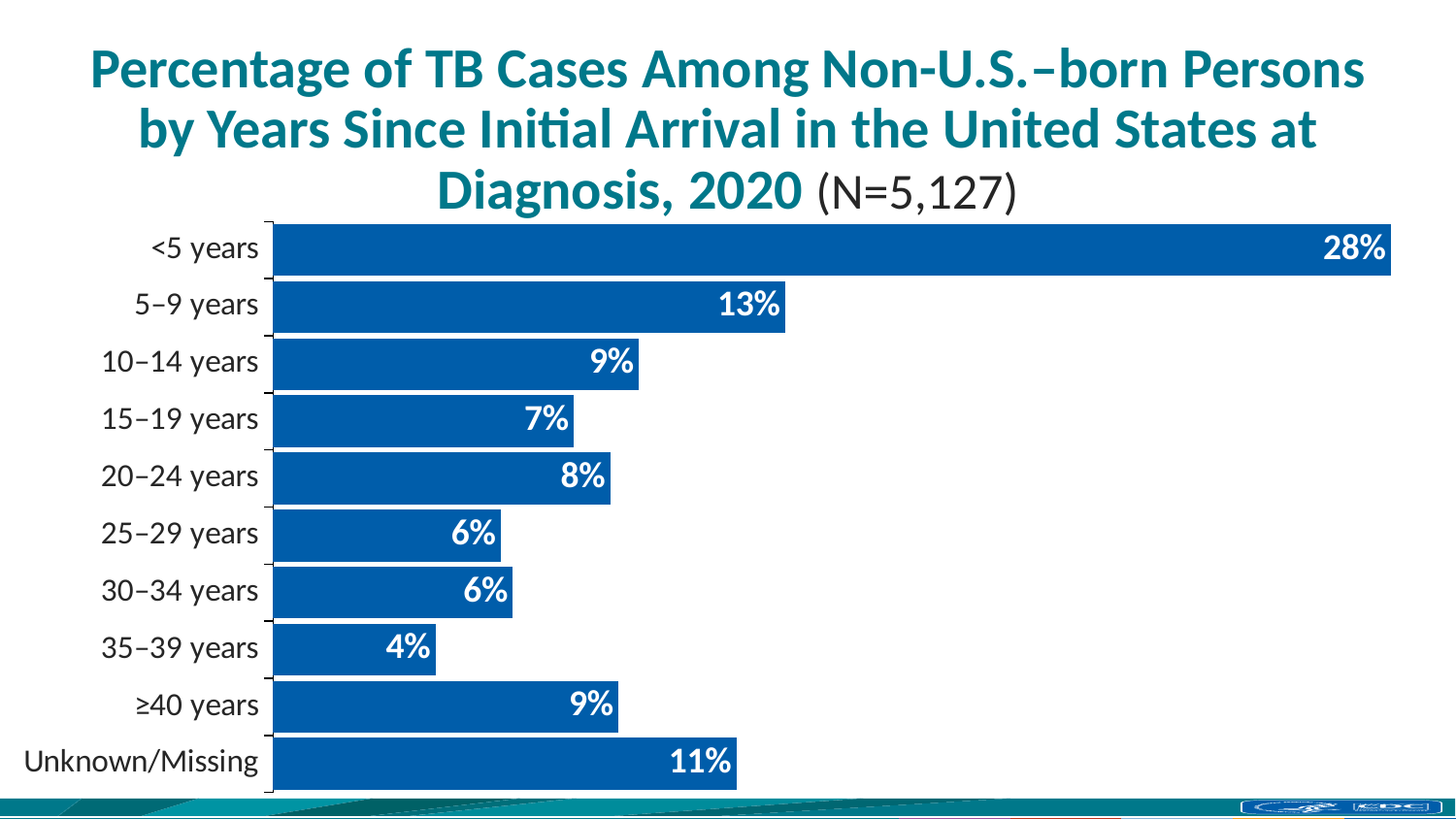
Which is larger, the value for 10–14 years or the value for 35–39 years? 10–14 years Which category has the highest percentage? <5 years What type of chart is shown on the slide? Bar chart What percentage is shown for the 5–9 years category? 13% What is the total number of cases (N) stated in the chart title? 5,127 How many categories are shown in the chart? 10 What is the value for the Unknown/Missing category? 11% Which category has the lowest percentage? 35–39 years What percentage of TB cases among non-U.S.-born persons were diagnosed <5 years since initial arrival? 28% What is the value for the ≥40 years category? 9% What is the difference between the 20–24 years and 15–19 years percentages? 1% What is the difference between the <5 years and 5–9 years percentages? 15%